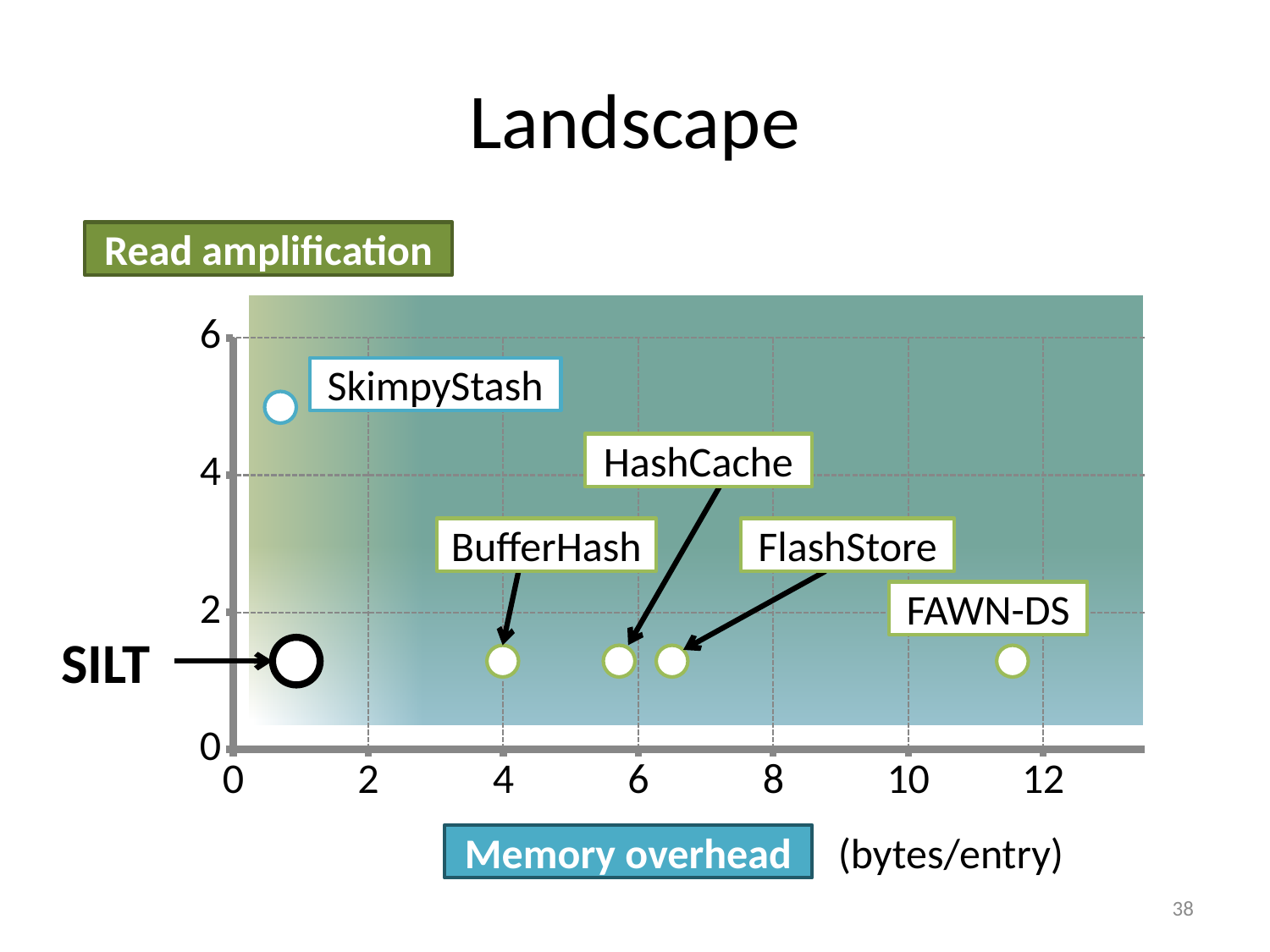
What is the label of the x axis? Memory overhead (bytes/entry) Is the memory overhead for FAWN-DS greater or less than 10? greater What is the title of the slide? Landscape What kind of chart is shown on the slide? scatter chart Which has the larger memory overhead, FAWN-DS or BufferHash? FAWN-DS Which system has the highest read amplification? SkimpyStash Which has the larger read amplification, SkimpyStash or HashCache? SkimpyStash Which system has the highest memory overhead? FAWN-DS Is the read amplification for SkimpyStash greater or less than 4? greater Is the read amplification for SILT greater or less than 2? less How many labeled data points are plotted on the chart? 6